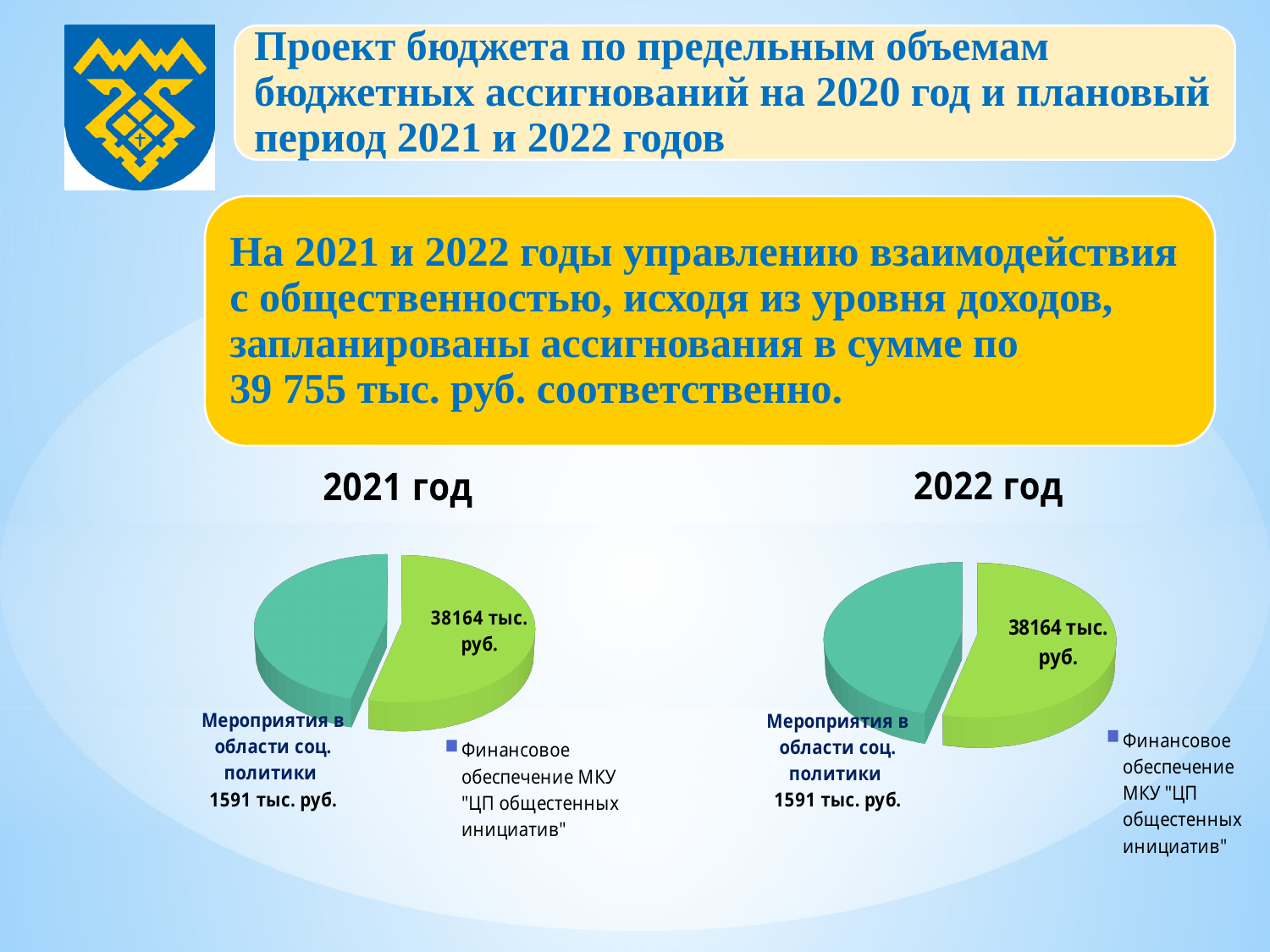
What is the title of the pie chart on the right side of the slide? 2022 год In the "2022 год" chart, which category has the smallest labelled value? Мероприятия в области соц. политики In the "2022 год" chart, what is the value for "Финансовое обеспечение МКУ "ЦП общественных инициатив""? 38164 тыс. руб. In the "2022 год" chart, what is the value for "Мероприятия в области соц. политики"? 1591 тыс. руб. In the "2021 год" chart, what is the value for "Мероприятия в области соц. политики"? 1591 тыс. руб. What is the total of the two labelled values in the "2022 год" chart? 39755 тыс. руб. How many slices does the "2022 год" pie chart have? 2 In the "2021 год" chart, what is the difference between the two labelled values (38164 and 1591 тыс. руб.)? 36573 тыс. руб. In the "2021 год" chart, what is the value for "Финансовое обеспечение МКУ "ЦП общественных инициатив""? 38164 тыс. руб. How many slices does the "2021 год" pie chart have? 2 What kind of chart is used for "2021 год"? pie chart In the "2021 год" chart, which category has the largest labelled value? Финансовое обеспечение МКУ "ЦП общественных инициатив"